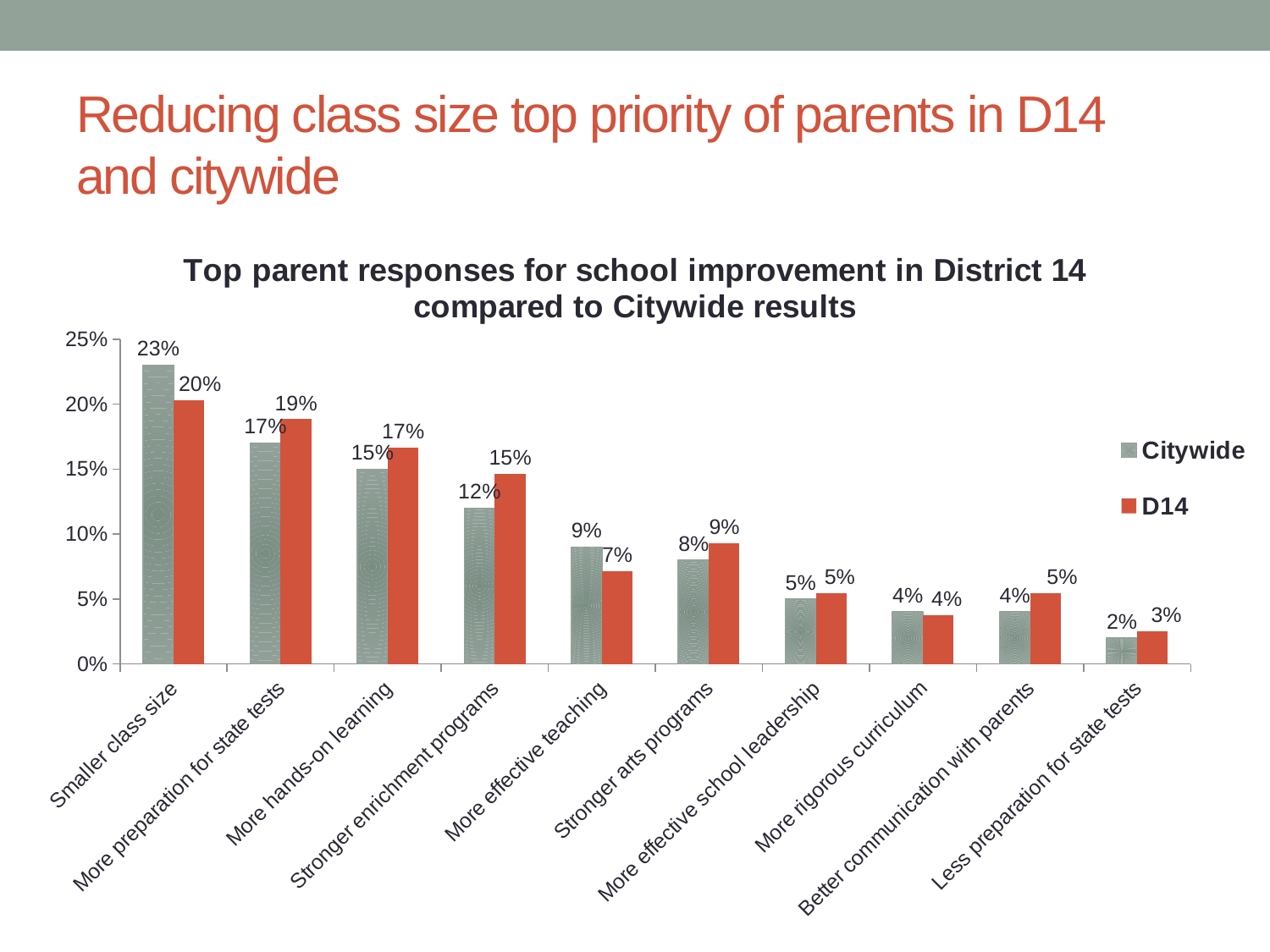
What is the D14 value for More preparation for state tests? 19% Which category has the lowest D14 value? Less preparation for state tests What kind of chart is shown on the slide? Bar chart What is the title of the chart? Top parent responses for school improvement in District 14 compared to Citywide results Which is larger for More effective teaching, the Citywide value or the D14 value? Citywide How many series does the legend list? 2 Which category has the highest Citywide value? Smaller class size What is the D14 value for Stronger enrichment programs? 15% How many categories are shown on the x axis? 10 What is the difference between the Citywide and D14 values for Smaller class size? 3% What is the Citywide value for More effective teaching? 9% What is the Citywide value for Smaller class size? 23%